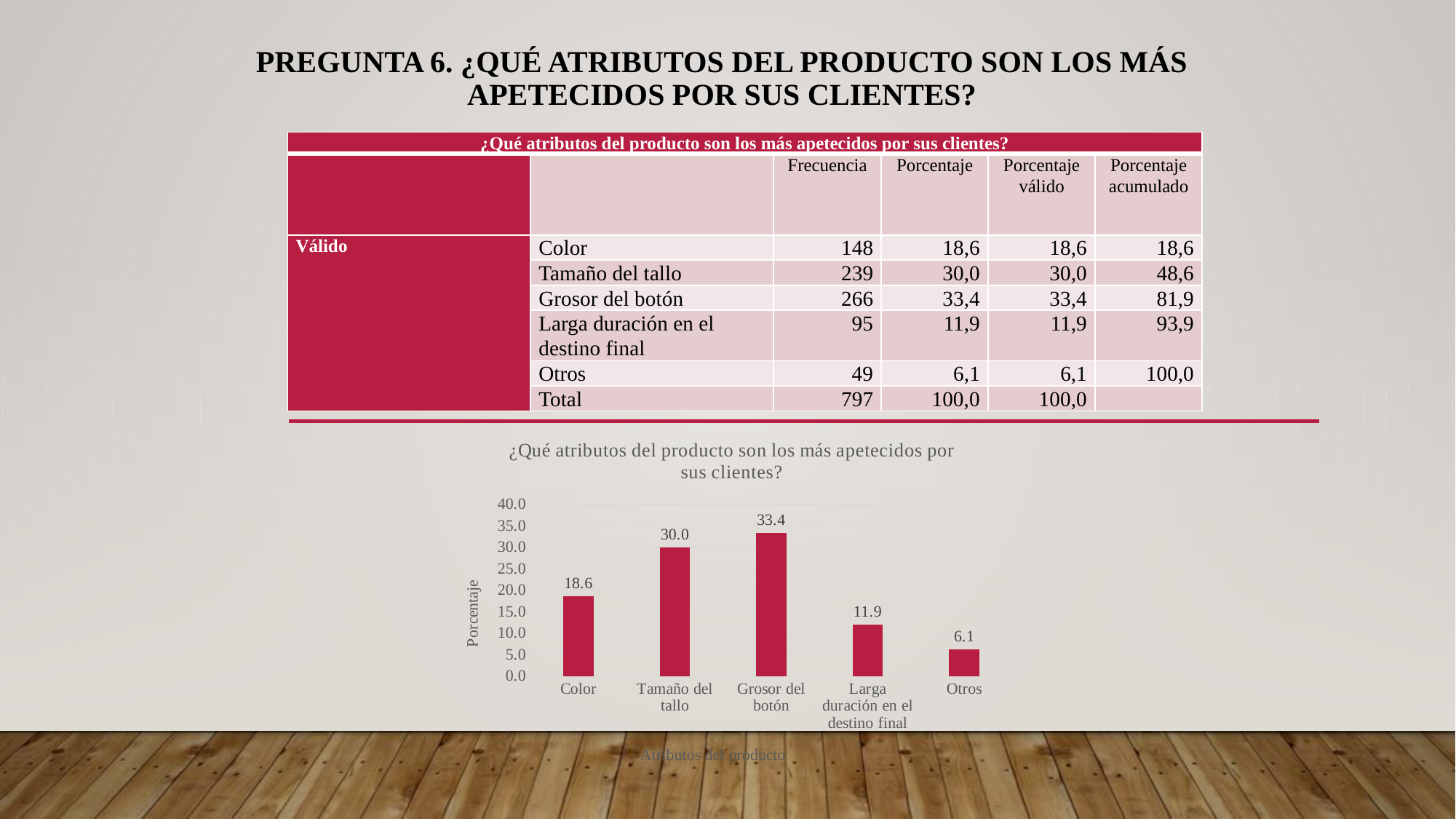
What is the value for Otros in the chart? 6.1 Which category has the highest value in the chart? Grosor del botón Is the value for Tamaño del tallo greater or less than 25.0? greater What is the value for Color in the chart? 18.6 Which category has the lowest value in the chart? Otros What is the value for Larga duración en el destino final in the chart? 11.9 What kind of chart is shown on the slide? bar chart What is the label of the vertical axis of the chart? Porcentaje What is the value for Grosor del botón in the chart? 33.4 What is the difference between the values for Grosor del botón and Tamaño del tallo? 3.4 Which is larger, the value for Color or the value for Larga duración en el destino final? Color How many categories are shown in the chart? 5